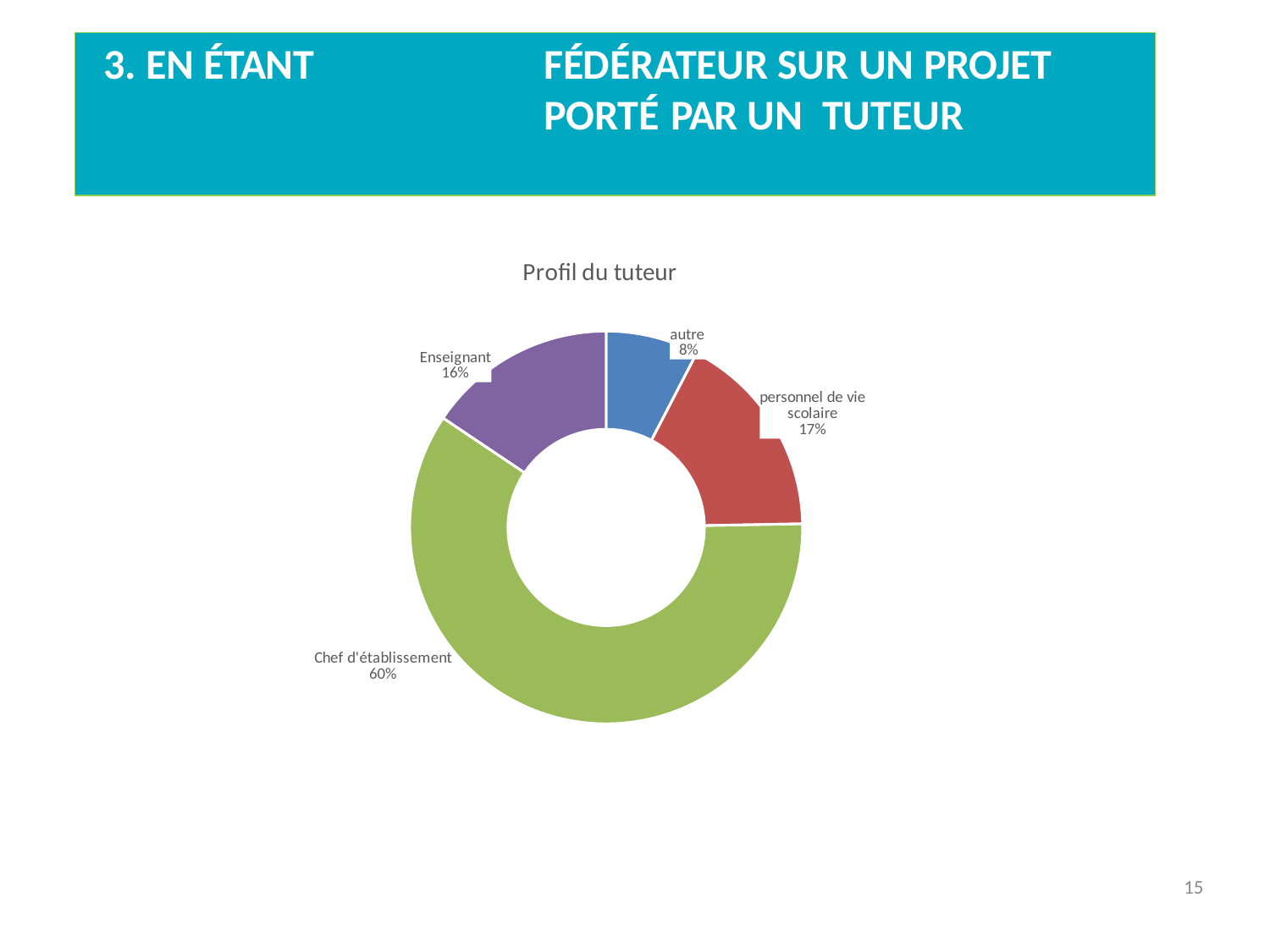
What colour is the Chef d'établissement segment? Green Which category has the smallest share? autre Which is larger, the share for personnel de vie scolaire or the share for autre? personnel de vie scolaire What kind of chart is shown on the slide? Doughnut chart What share of the chart does Chef d'établissement represent? 60% What is the value shown for Enseignant? 16% What is the difference between the shares of Chef d'établissement and Enseignant? 44 percentage points What is the title of the chart? Profil du tuteur Which category has the largest share? Chef d'établissement What is the value shown for personnel de vie scolaire? 17% What is the value shown for the 'autre' category? 8% How many categories are shown in the chart? 4